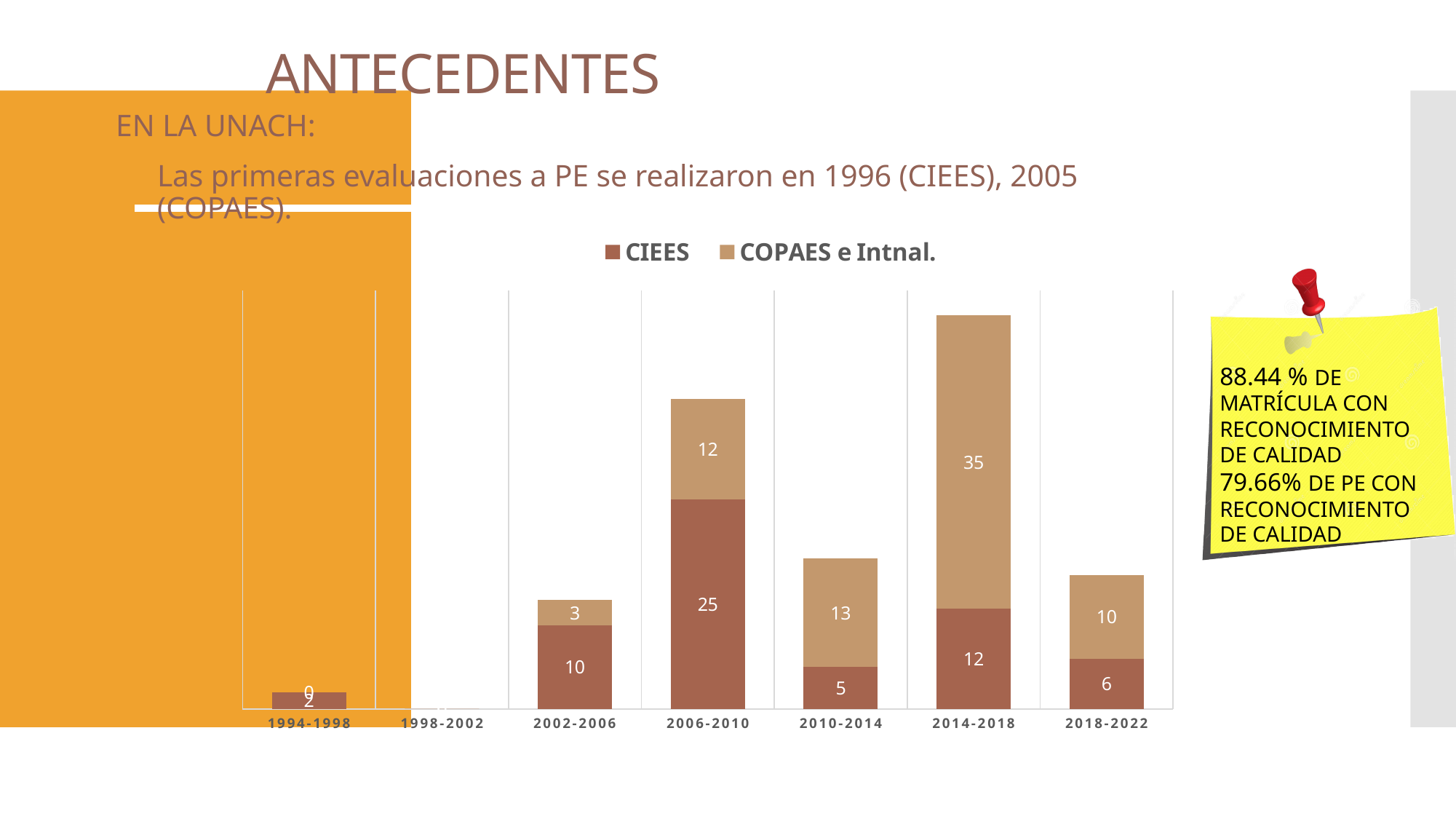
What is the difference between the COPAES e Intnal. value and the CIEES value for 2010-2014? 8 Which is larger for 2002-2006, the CIEES value or the COPAES e Intnal. value? CIEES What is the COPAES e Intnal. value for 2014-2018? 35 What is the COPAES e Intnal. value for 2018-2022? 10 What is the total of the stacked bar for 2006-2010? 37 Which period has the highest CIEES value? 2006-2010 What is the CIEES value for 2006-2010? 25 What is the total of the stacked bar for 2014-2018? 47 What is the CIEES value for 2010-2014? 5 What type of chart is shown on the slide? Stacked bar chart Which period has the highest COPAES e Intnal. value? 2014-2018 How many series does the chart legend list? 2